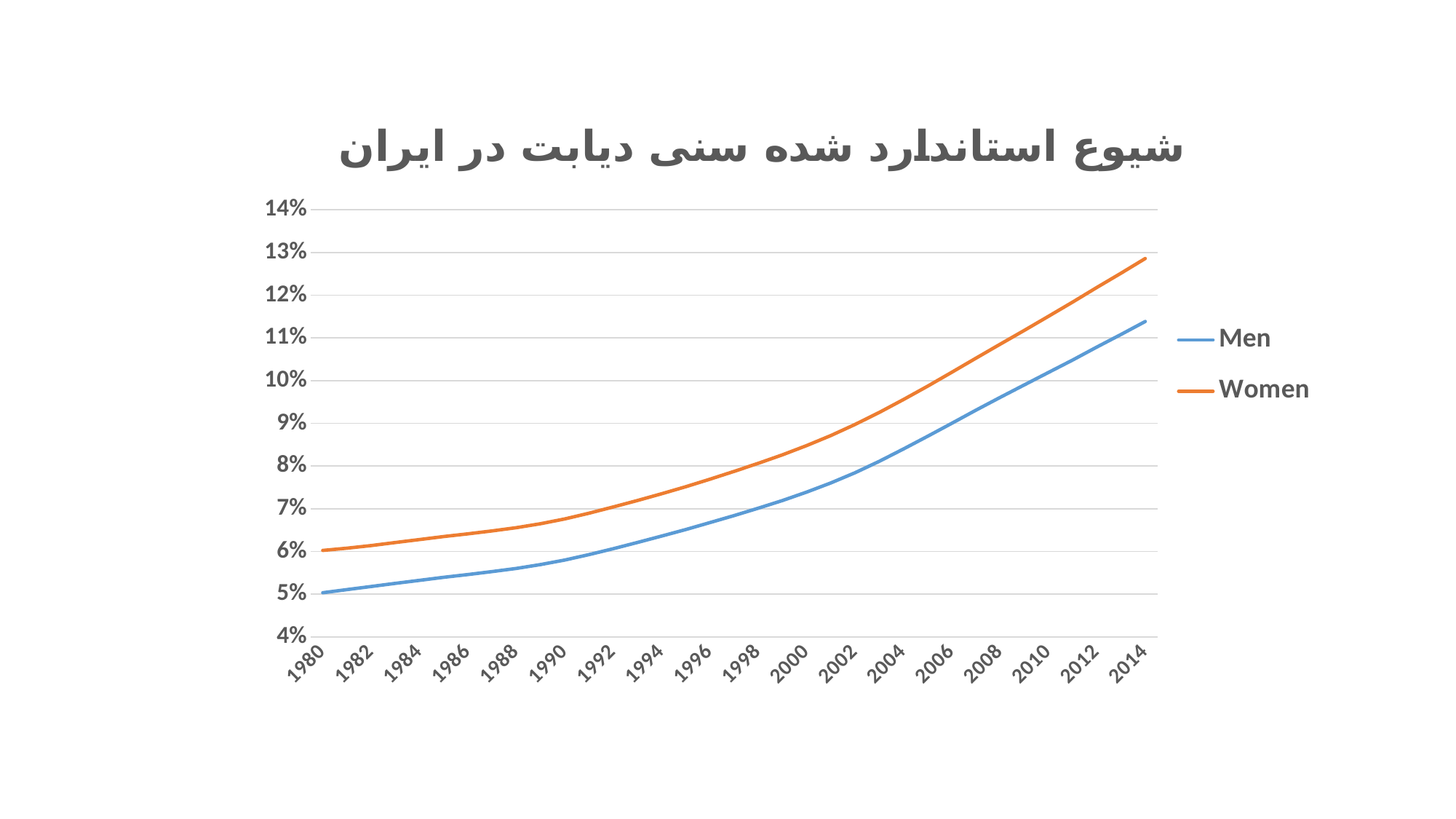
Which series has the higher value in 2014, Men or Women? Women Is the value for Men in 2000 greater or less than 8%? less Do the values for Men rise or fall from 1980 to 2014? rise Is the value for Women in 1990 greater or less than 7%? less Do the values for Women rise or fall from 1980 to 2014? rise How many series does the legend list? 2 What kind of chart is shown on the slide? line chart Is the value for Women in 2014 greater or less than 12%? greater What colour is the line for the Women series? orange Which series has the lower value in 1980, Men or Women? Men How many years are labelled on the x axis? 18